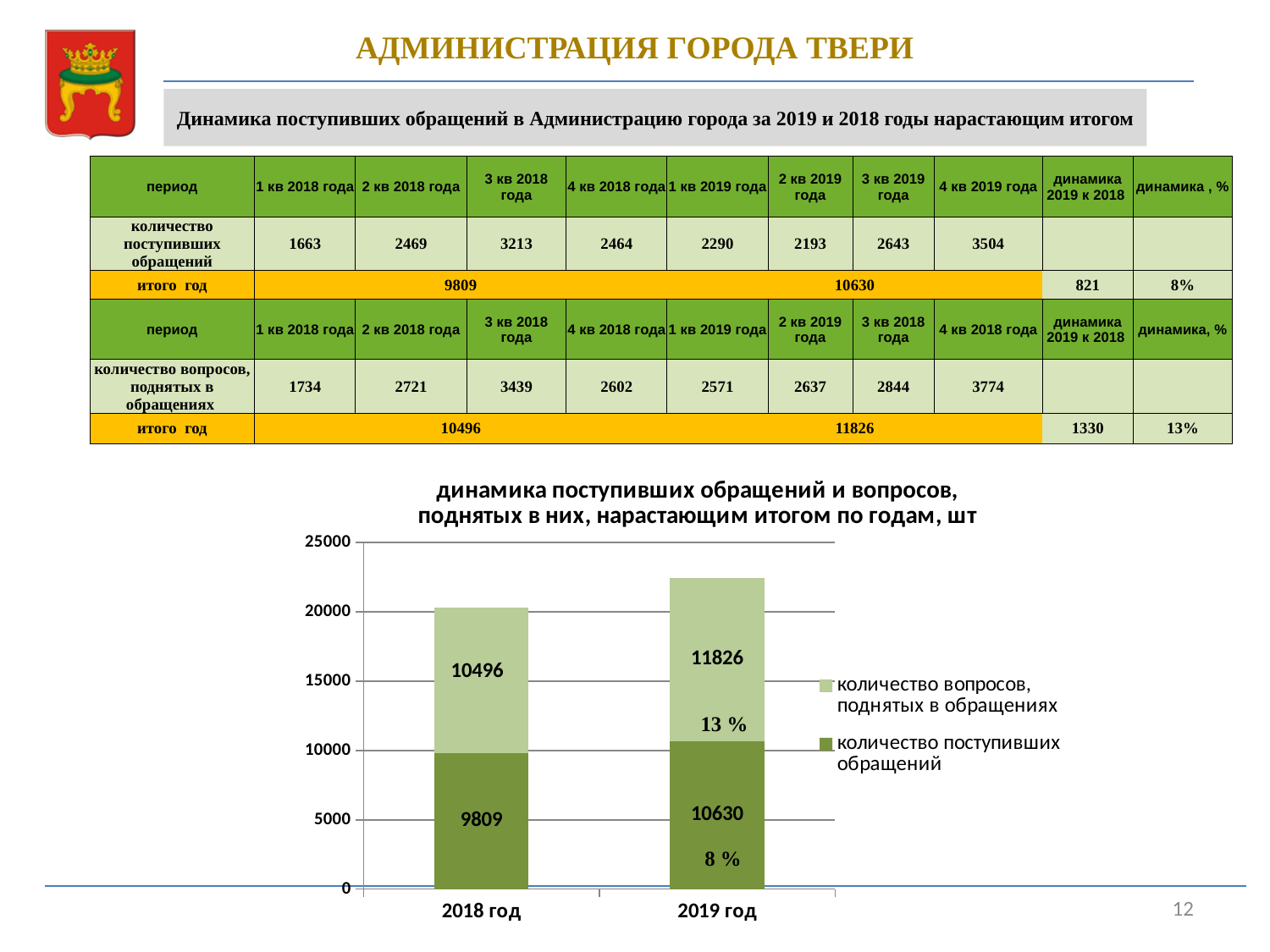
In the chart, what is the value of 'количество вопросов, поднятых в обращениях' for 2018 год? 10496 In the chart, what is the value of 'количество поступивших обращений' for 2018 год? 9809 In the chart, what is the value of 'количество вопросов, поднятых в обращениях' for 2019 год? 11826 How many categories (years) are shown on the x axis of the chart? 2 What type of chart is shown on the slide? stacked bar chart In the chart, what is the total of the stacked bar for 2018 год? 20305 In the chart, is the total stacked bar for 2019 год greater or less than 20000? greater In the chart, what is the value of 'количество поступивших обращений' for 2019 год? 10630 In the chart, what is the difference between 'количество вопросов, поднятых в обращениях' in 2019 год and 2018 год? 1330 In the chart, which year has the larger value for 'количество поступивших обращений', 2018 год or 2019 год? 2019 год In the chart, what is the total of the stacked bar for 2019 год? 22456 How many series does the chart legend list? 2